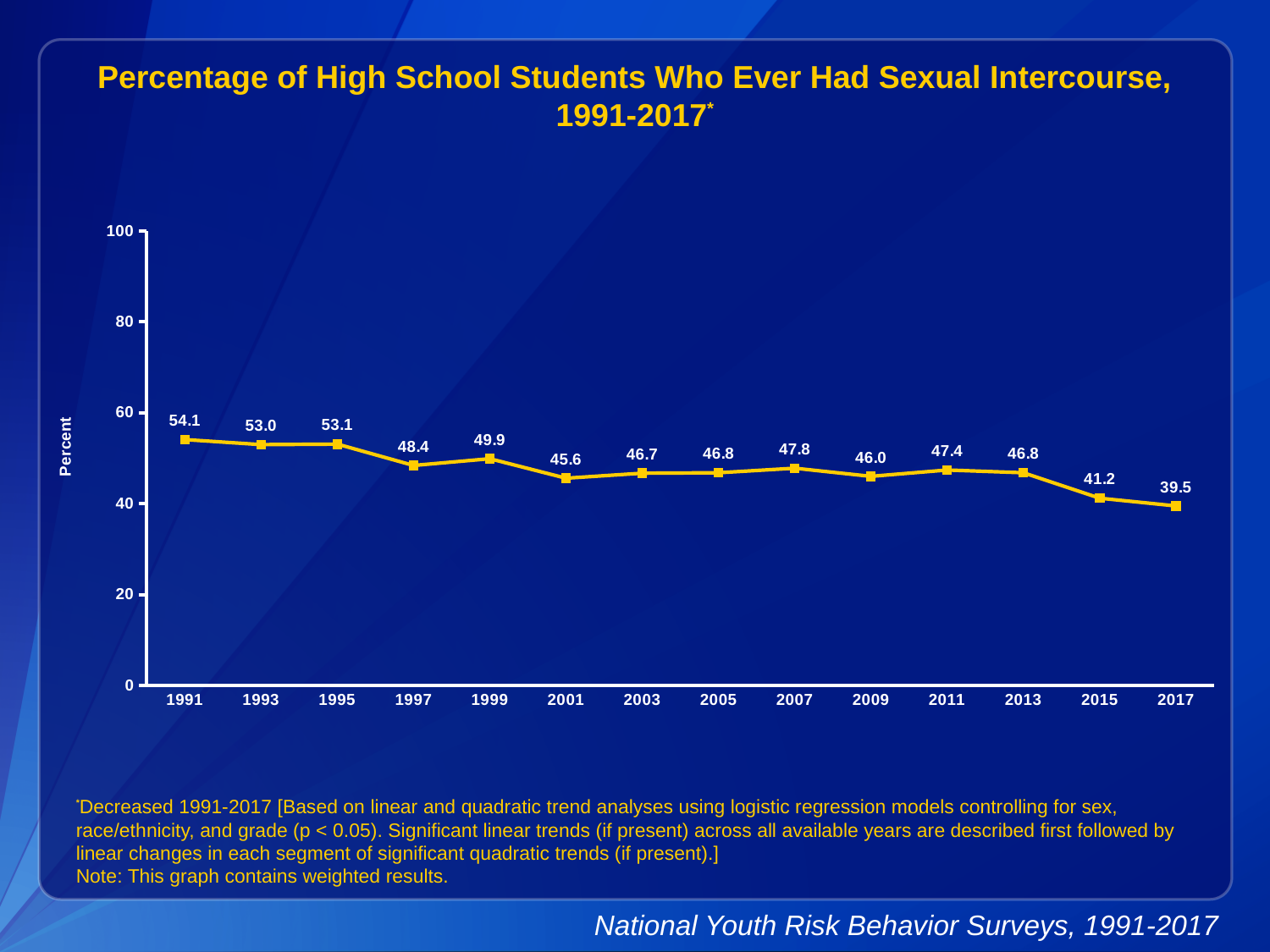
What was the percentage in 2017? 39.5 How many years are plotted on the x axis? 14 Do the values generally rise or fall from 1991 to 2017? Fall Is the value for 2015 greater or less than 40? greater Which year has the highest percentage? 1991 What kind of chart is shown on the slide? Line chart Which year has a higher value, 1999 or 2001? 1999 What is the difference between the 1991 value and the 2017 value? 14.6 What is the difference between the 2013 value and the 2015 value? 5.6 Which year has the lowest percentage? 2017 What value is shown for 2001? 45.6 What was the percentage of high school students who ever had sexual intercourse in 1991? 54.1